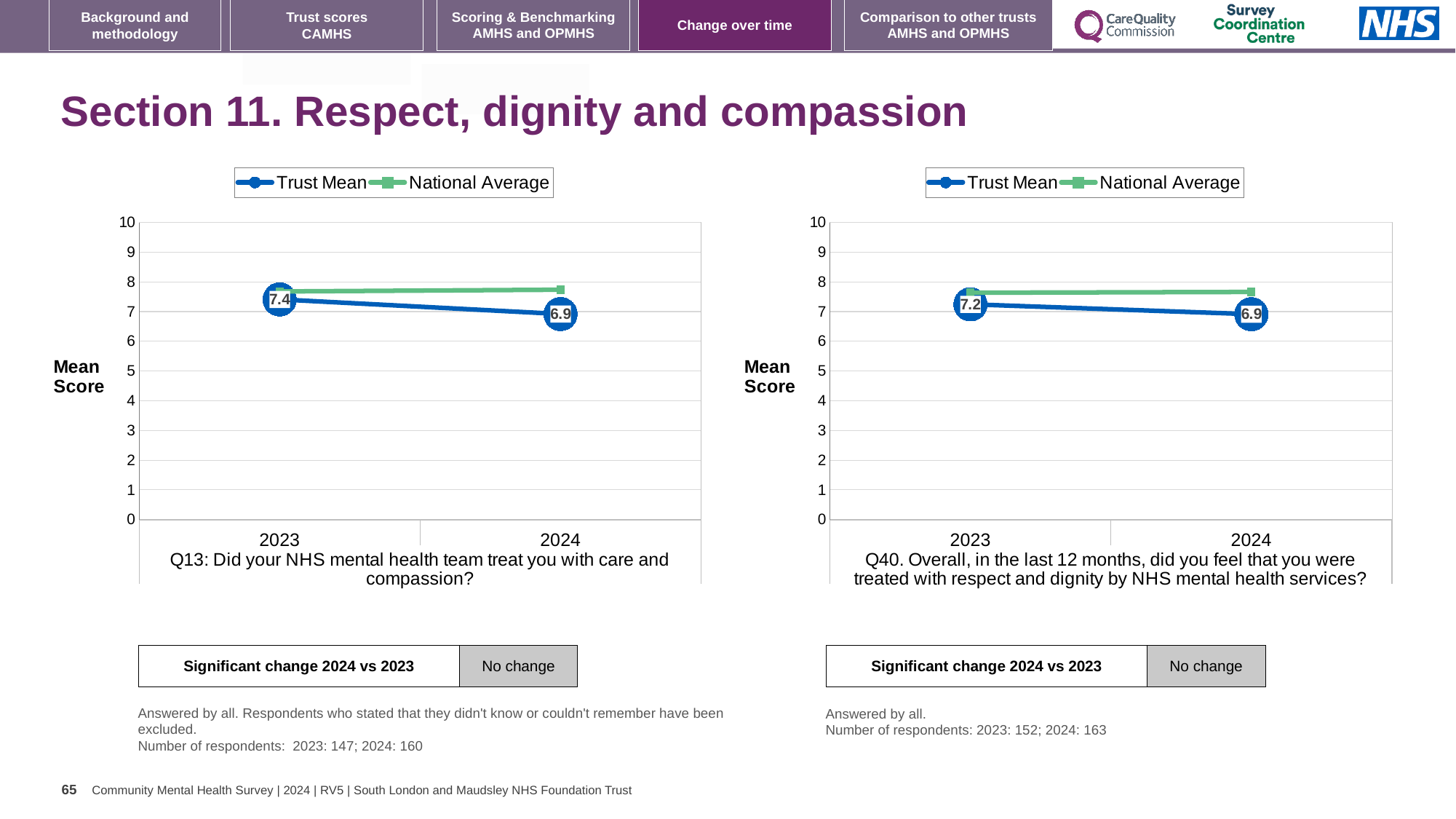
In the Q13 chart (left), by how much did the Trust Mean change from 2023 to 2024? 0.5 In the Q13 chart (left), what is the Trust Mean for 2023? 7.4 In the Q40 chart (right), what is the Trust Mean for 2024? 6.9 In the Q13 chart (left), is the National Average for 2024 greater or less than 7? greater In the Q40 chart (right), what is the difference between the Trust Mean in 2023 and 2024? 0.3 How many series does the legend of the Q40 chart (right) list? 2 In the Q13 chart (left), does the Trust Mean rise or fall from 2023 to 2024? fall What kind of chart is the Q13 chart (left)? line chart In the Q13 chart (left), what is the Trust Mean for 2024? 6.9 In the Q40 chart (right), which is higher in 2024, the Trust Mean or the National Average? National Average How many years are plotted on the x axis of the Q40 chart (right)? 2 In the Q40 chart (right), what is the Trust Mean for 2023? 7.2